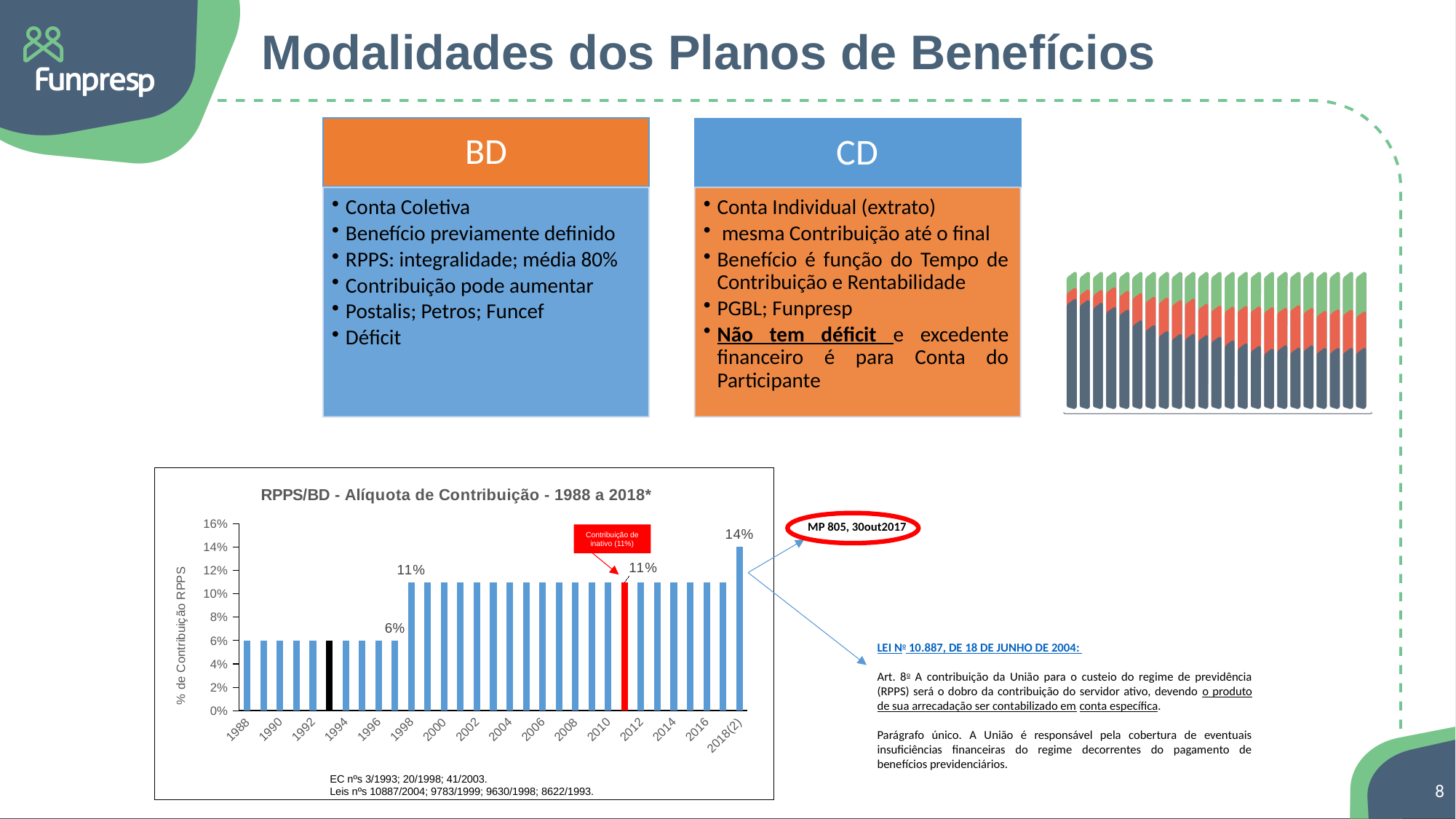
In the chart 'RPPS/BD - Alíquota de Contribuição - 1988 a 2018*', what is the contribution rate shown for 1988? 6% In the chart 'RPPS/BD - Alíquota de Contribuição - 1988 a 2018*', what is the difference between the value for 2018(2) and the value for 1998? 3 percentage points In the chart 'RPPS/BD - Alíquota de Contribuição - 1988 a 2018*', which year has the highest contribution rate? 2018(2) In the chart 'RPPS/BD - Alíquota de Contribuição - 1988 a 2018*', what value is labelled on the red bar (2011)? 11% In the chart 'RPPS/BD - Alíquota de Contribuição - 1988 a 2018*', what does the red callout box above the red bar say? Contribuição de inativo (11%) In the chart 'RPPS/BD - Alíquota de Contribuição - 1988 a 2018*', what is the value shown for 2018(2)? 14% What kind of chart is 'RPPS/BD - Alíquota de Contribuição - 1988 a 2018*'? bar chart In the chart 'RPPS/BD - Alíquota de Contribuição - 1988 a 2018*', do the values rise or fall from 1988 to 2018(2)? rise In the chart 'RPPS/BD - Alíquota de Contribuição - 1988 a 2018*', which is larger, the value for 1990 or the value for 1998? 1998 In the chart 'RPPS/BD - Alíquota de Contribuição - 1988 a 2018*', is the value for 2000 greater or less than 10%? greater In the chart 'RPPS/BD - Alíquota de Contribuição - 1988 a 2018*', how much higher is the 1998 rate than the 1988 rate? 5 percentage points What is the y-axis label of the chart 'RPPS/BD - Alíquota de Contribuição - 1988 a 2018*'? % de Contribuição RPPS